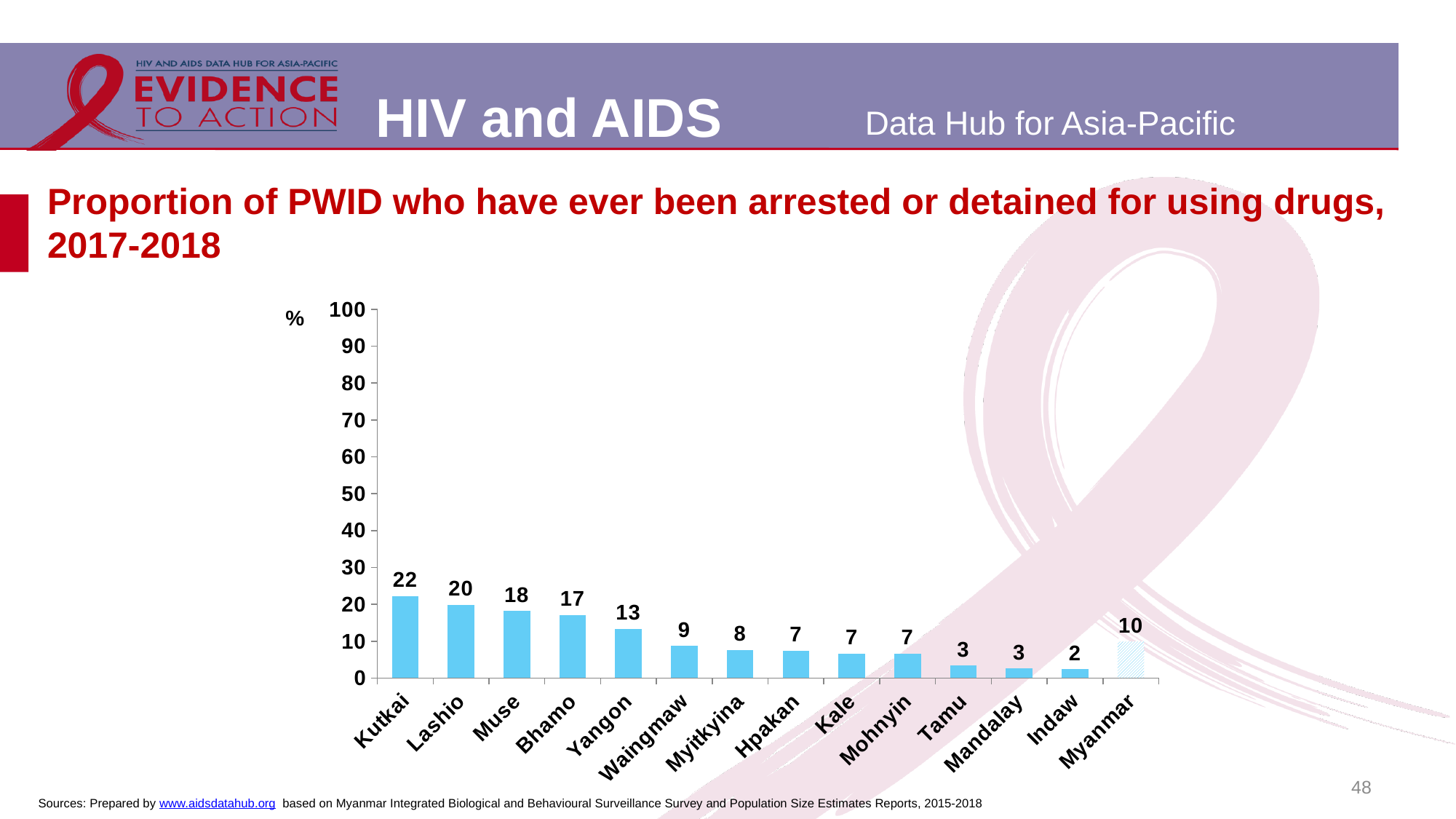
What is the value for Myanmar? 10 What is the value for Indaw? 2 Which category has the lowest value? Indaw What is the title of the chart? Proportion of PWID who have ever been arrested or detained for using drugs, 2017-2018 What is the value for Yangon? 13 How many categories are shown on the x axis? 14 Which category has the highest value? Kutkai What is the difference between the values for Kutkai and Lashio? 2 What kind of chart is shown on the slide? Bar chart What is the difference between the values for Muse and Myanmar? 8 What is the value for Kutkai? 22 Which is larger, the value for Bhamo or the value for Waingmaw? Bhamo